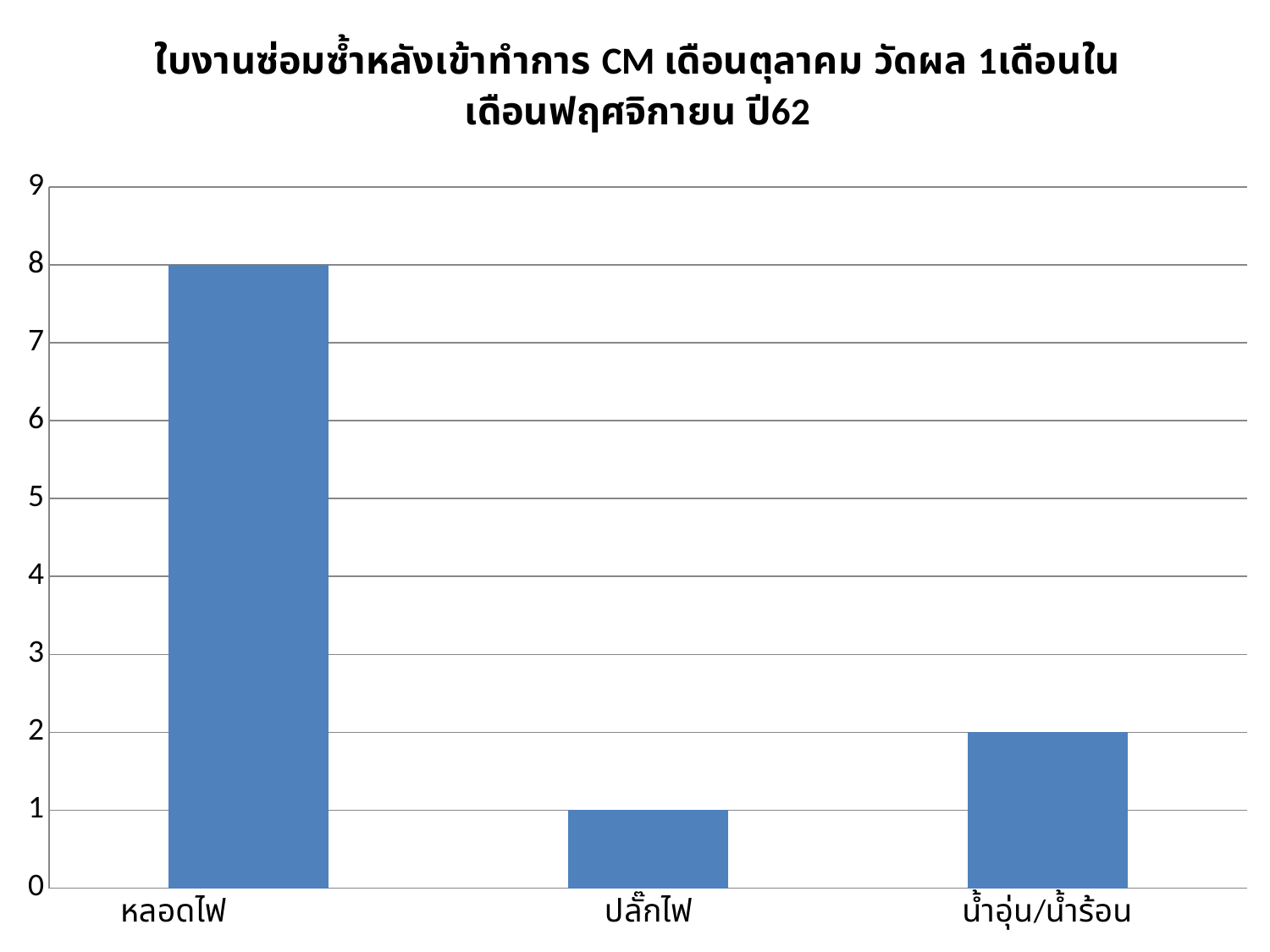
What is the value for หลอดไฟ? 8 What is the maximum value shown on the y axis? 9 What is the difference between the values for หลอดไฟ and น้ำอุ่น/น้ำร้อน? 6 How many categories are shown on the x axis? 3 What kind of chart is shown on the slide? bar chart What is the value for ปลั๊กไฟ? 1 Is the value for หลอดไฟ greater or less than 5? greater What is the value for น้ำอุ่น/น้ำร้อน? 2 What colour are the bars in the chart? blue Which category has the lowest value? ปลั๊กไฟ Which is larger, the value for ปลั๊กไฟ or the value for น้ำอุ่น/น้ำร้อน? น้ำอุ่น/น้ำร้อน Which category has the highest value? หลอดไฟ